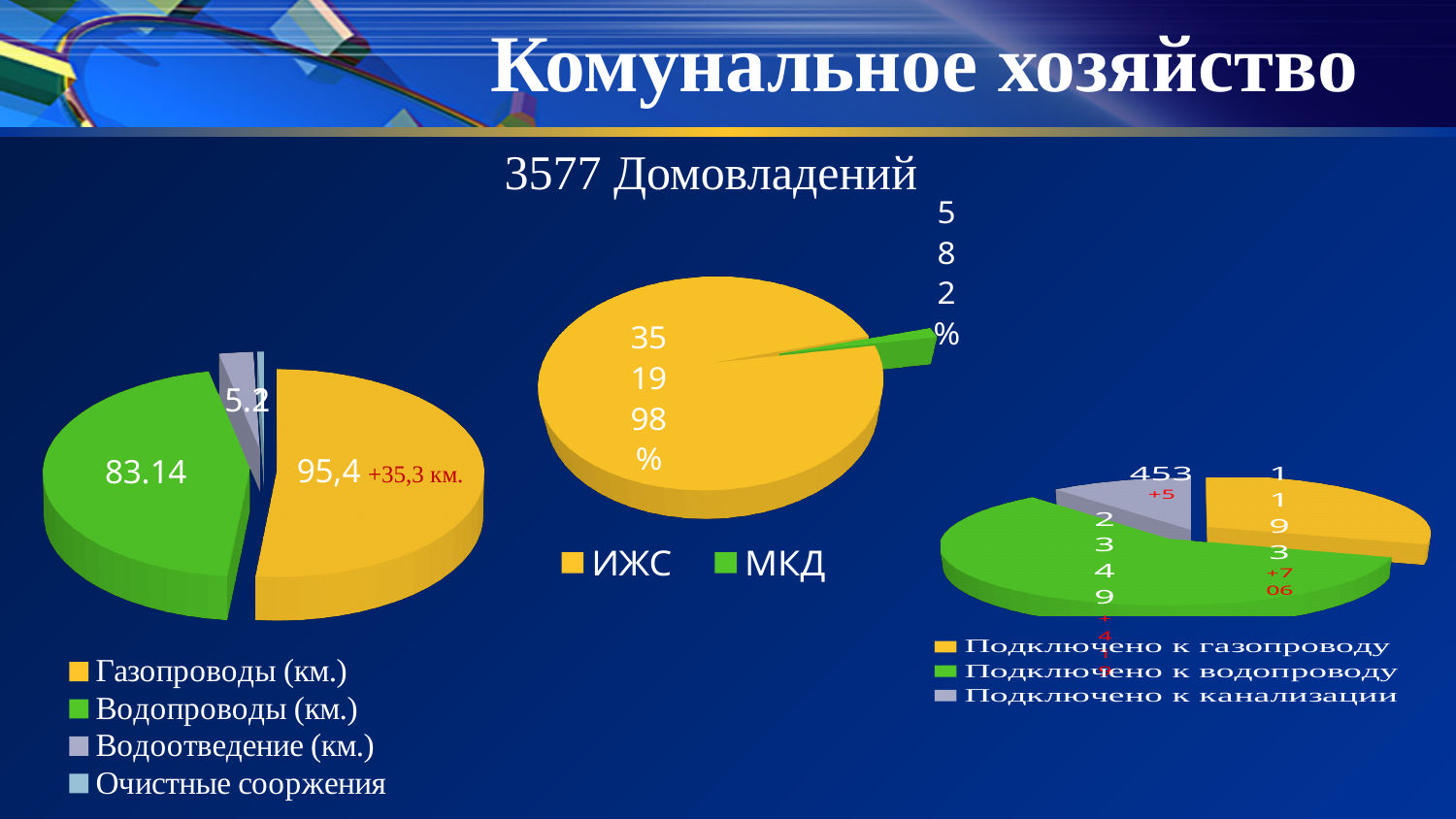
In the left pie chart, what is the value for Газопроводы (км.)? 95,4 In the right pie chart, which category has the smallest slice? Подключено к канализации How many entries does the legend of the middle pie chart list? 2 In the left pie chart, which is larger: Газопроводы (км.) or Водопроводы (км.)? Газопроводы (км.) In the left pie chart, what is the value for Водопроводы (км.)? 83.14 How many entries does the legend of the left pie chart list? 4 In the middle pie chart, which slice is larger: ИЖС or МКД? ИЖС How many entries does the legend of the right pie chart list? 3 What kind of chart is the left chart on the slide? Pie chart In the right pie chart, which category has the largest slice? Подключено к водопроводу In the right pie chart, what is the value for Подключено к канализации? 453 What is the title of the middle pie chart? 3577 Домовладений